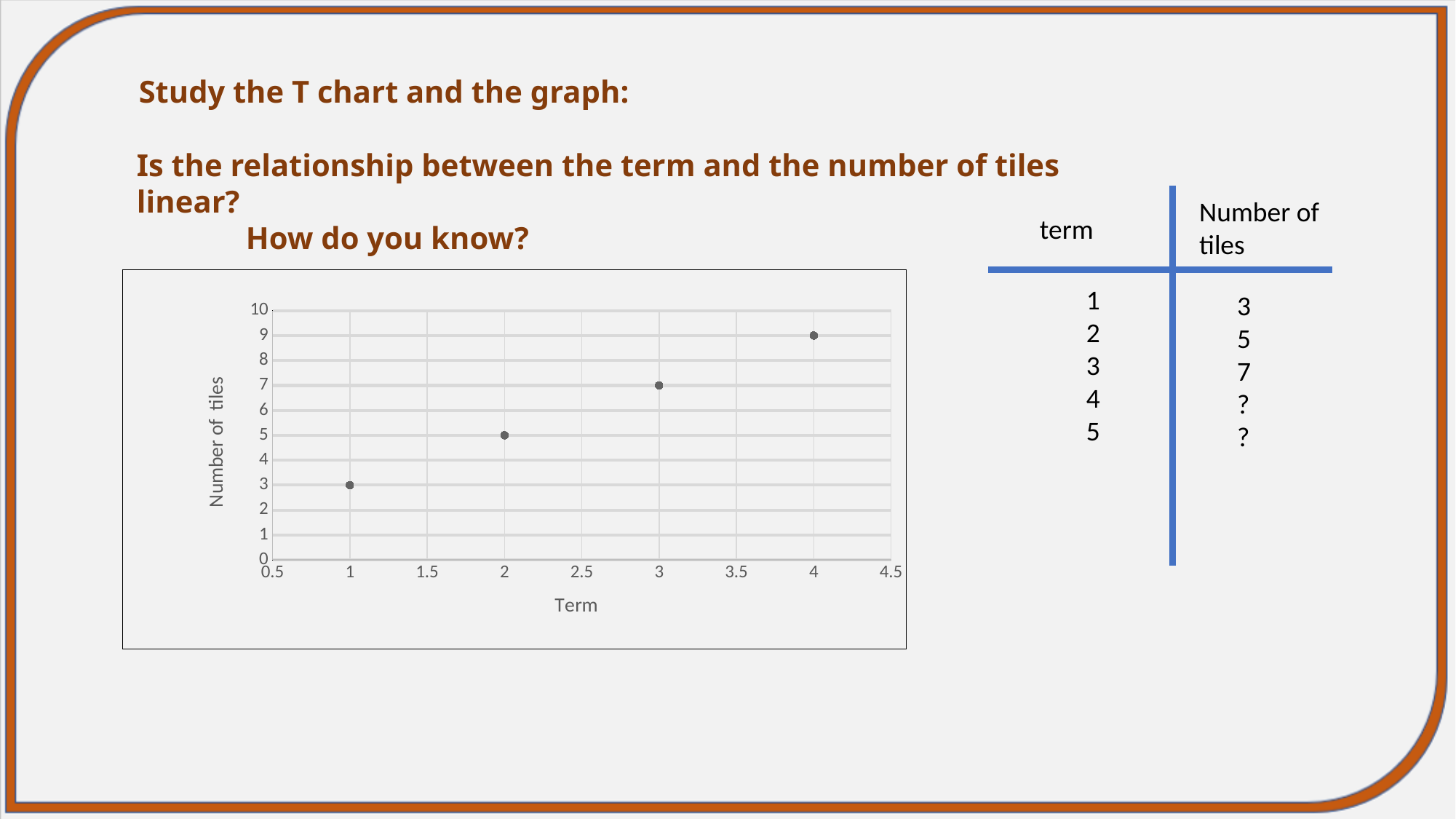
What is the label of the vertical axis of the chart? Number of tiles What is the difference in number of tiles between term 4 and term 1? 6 What is the number of tiles for term 4 on the chart? 9 Which has more tiles, term 2 or term 3? term 3 What type of chart is shown on the slide? scatter plot Which term has the lowest number of tiles on the chart? 1 Do the values rise or fall as the term increases along the x axis? rise What is the number of tiles for term 3 on the chart? 7 Which term has the highest number of tiles on the chart? 4 How many data points are plotted on the chart? 4 What is the number of tiles for term 1 on the chart? 3 What is the number of tiles for term 2 on the chart? 5